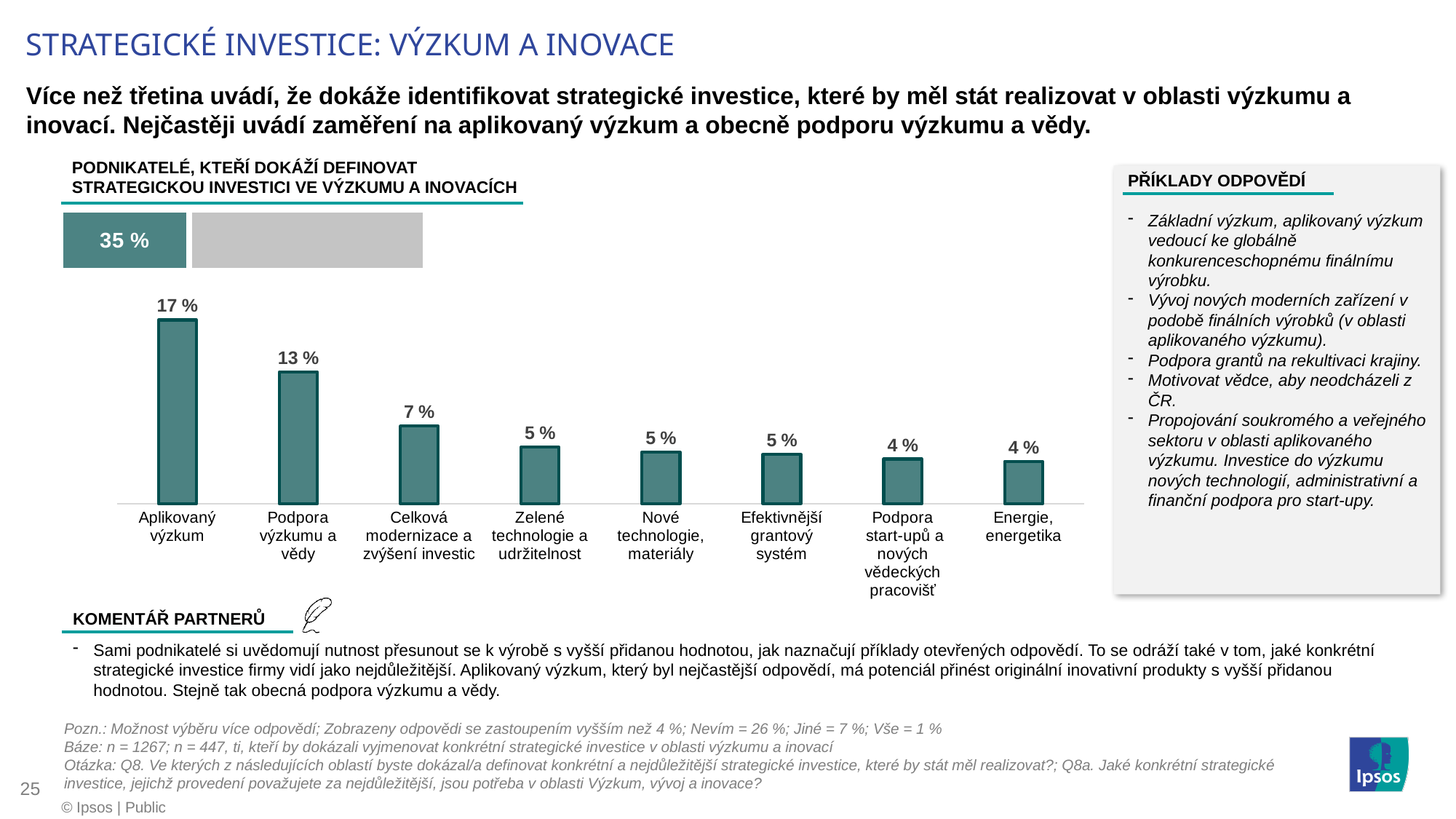
Which category has the highest value in the bar chart? Aplikovaný výzkum How many categories are shown in the bar chart? 8 What is the value for Energie, energetika in the bar chart? 4 % What percentage is shown in the bar under the heading 'Podnikatelé, kteří dokáží definovat strategickou investici ve výzkumu a inovacích'? 35 % What is the value for Aplikovaný výzkum in the bar chart? 17 % What is the difference between the values for Podpora výzkumu a vědy and Celková modernizace a zvýšení investic? 6 % What is the value for Podpora výzkumu a vědy in the bar chart? 13 % What kind of chart is used to show the categories from Aplikovaný výzkum to Energie, energetika? Bar chart Which is larger in the bar chart: Celková modernizace a zvýšení investic or Zelené technologie a udržitelnost? Celková modernizace a zvýšení investic What is the difference between the values for Aplikovaný výzkum and Podpora výzkumu a vědy? 4 % Do the values in the bar chart rise or fall from left to right? Fall What is the value for Celková modernizace a zvýšení investic in the bar chart? 7 %